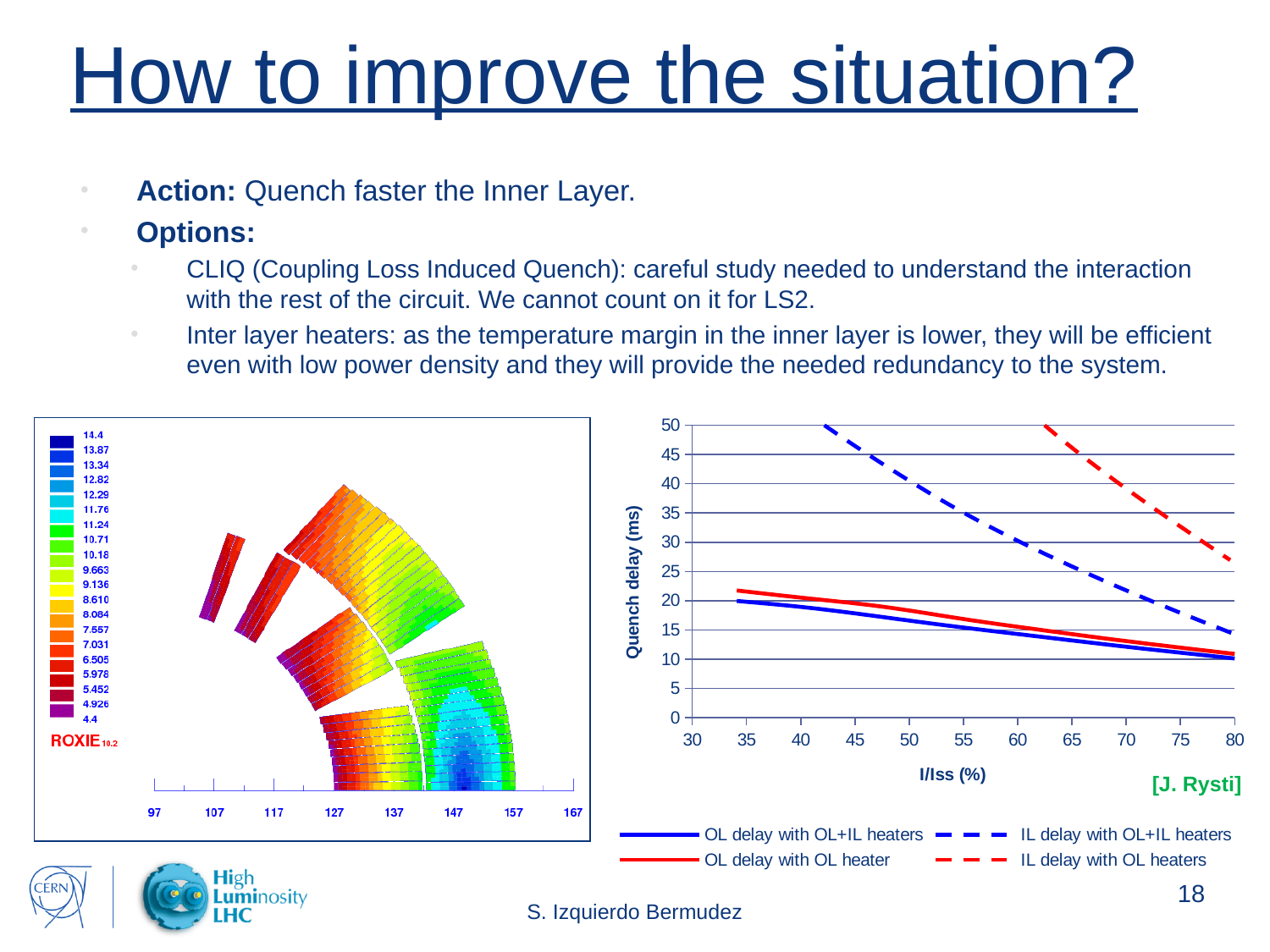
In the quench delay chart, does the quench delay rise or fall as I/Iss increases? fall In the quench delay chart, at I/Iss = 70%, which is larger: 'IL delay with OL heaters' or 'IL delay with OL+IL heaters'? IL delay with OL heaters What kind of chart is the chart on the right of the slide (Quench delay vs I/Iss)? line chart In the quench delay chart, is the value for 'OL delay with OL heater' at I/Iss = 80% greater or less than 15? less In the quench delay chart, which series is drawn as a dashed red line? IL delay with OL heaters In the quench delay chart, is the value for 'IL delay with OL+IL heaters' at I/Iss = 80% greater or less than 20? less What is the label of the vertical axis of the quench delay chart? Quench delay (ms) In the quench delay chart, is the value for 'IL delay with OL heaters' at I/Iss = 80% greater or less than 20? greater In the quench delay chart, at I/Iss = 65%, which is larger: 'IL delay with OL+IL heaters' or 'OL delay with OL+IL heaters'? IL delay with OL+IL heaters How many series does the legend of the quench delay chart list? 4